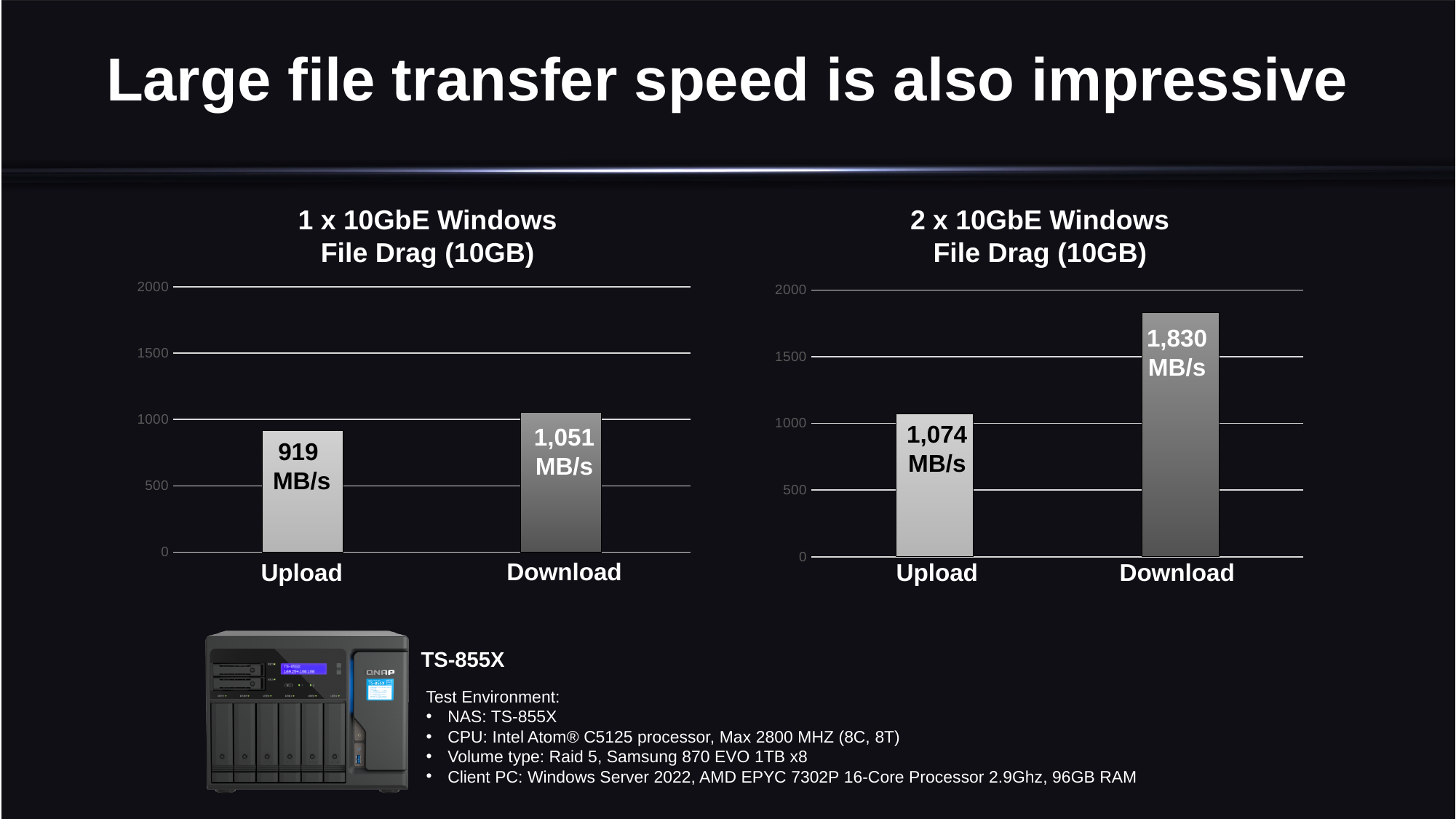
In the '2 x 10GbE Windows File Drag (10GB)' chart, what is the Download value? 1,830 MB/s In the '1 x 10GbE Windows File Drag (10GB)' chart, which category has the lowest value? Upload In the '2 x 10GbE Windows File Drag (10GB)' chart, which category has the highest value? Download How many categories are shown in the '2 x 10GbE Windows File Drag (10GB)' chart? 2 Which is larger: the Download value in the '1 x 10GbE' chart or the Upload value in the '2 x 10GbE' chart? Upload in the 2 x 10GbE chart In the '2 x 10GbE Windows File Drag (10GB)' chart, what is the Upload value? 1,074 MB/s In the '1 x 10GbE Windows File Drag (10GB)' chart, what is the Upload value? 919 MB/s In the '1 x 10GbE Windows File Drag (10GB)' chart, what is the Download value? 1,051 MB/s What type of chart is the '1 x 10GbE Windows File Drag (10GB)' chart? bar chart In the '1 x 10GbE Windows File Drag (10GB)' chart, what is the difference between the Download and Upload values? 132 MB/s In the '2 x 10GbE Windows File Drag (10GB)' chart, what is the difference between the Download and Upload values? 756 MB/s In the '1 x 10GbE Windows File Drag (10GB)' chart, is the Upload value greater or less than 1000? less